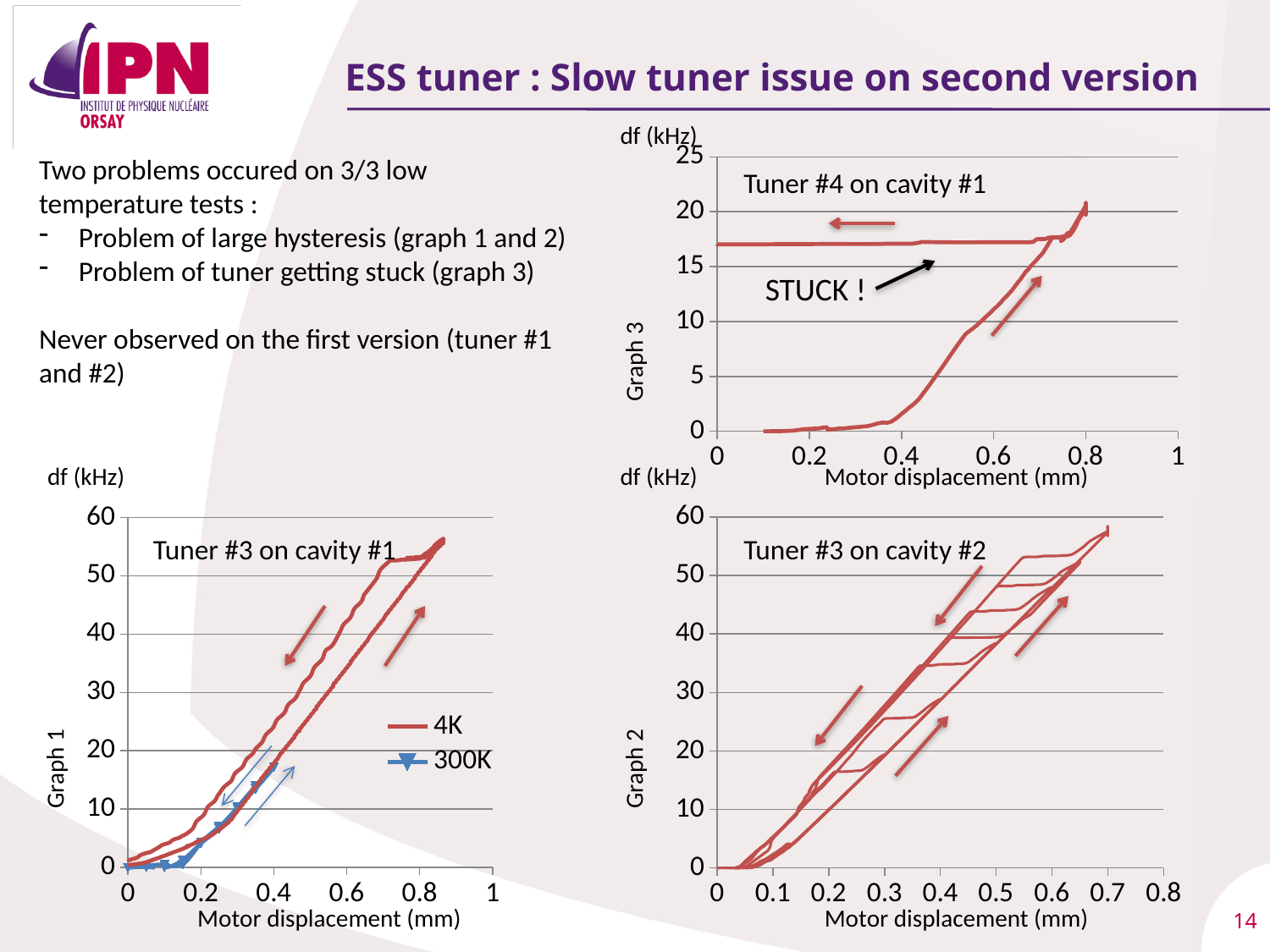
In Graph 1 (Tuner #3 on cavity #1), does df generally rise or fall as motor displacement increases? rise How many series does the legend of Graph 1 (Tuner #3 on cavity #1) list? 2 In Graph 1 (Tuner #3 on cavity #1), is the maximum df reached by the 4K series greater or less than 50 kHz? greater What annotation text is written next to the flat plateau in Graph 3 (Tuner #4 on cavity #1)? STUCK ! In Graph 2 (Tuner #3 on cavity #2), is the maximum df reached greater or less than 50 kHz? greater In Graph 1 (Tuner #3 on cavity #1), which series reaches the higher maximum df: 4K or 300K? 4K What kind of chart is Graph 1 (Tuner #3 on cavity #1)? line chart What is the x-axis label of Graph 2 (Tuner #3 on cavity #2)? Motor displacement (mm) In Graph 1 (Tuner #3 on cavity #1), is the maximum df reached by the 300K series greater or less than 20 kHz? less Which chart reaches a higher maximum df: Graph 2 (Tuner #3 on cavity #2) or Graph 3 (Tuner #4 on cavity #1)? Graph 2 (Tuner #3 on cavity #2)